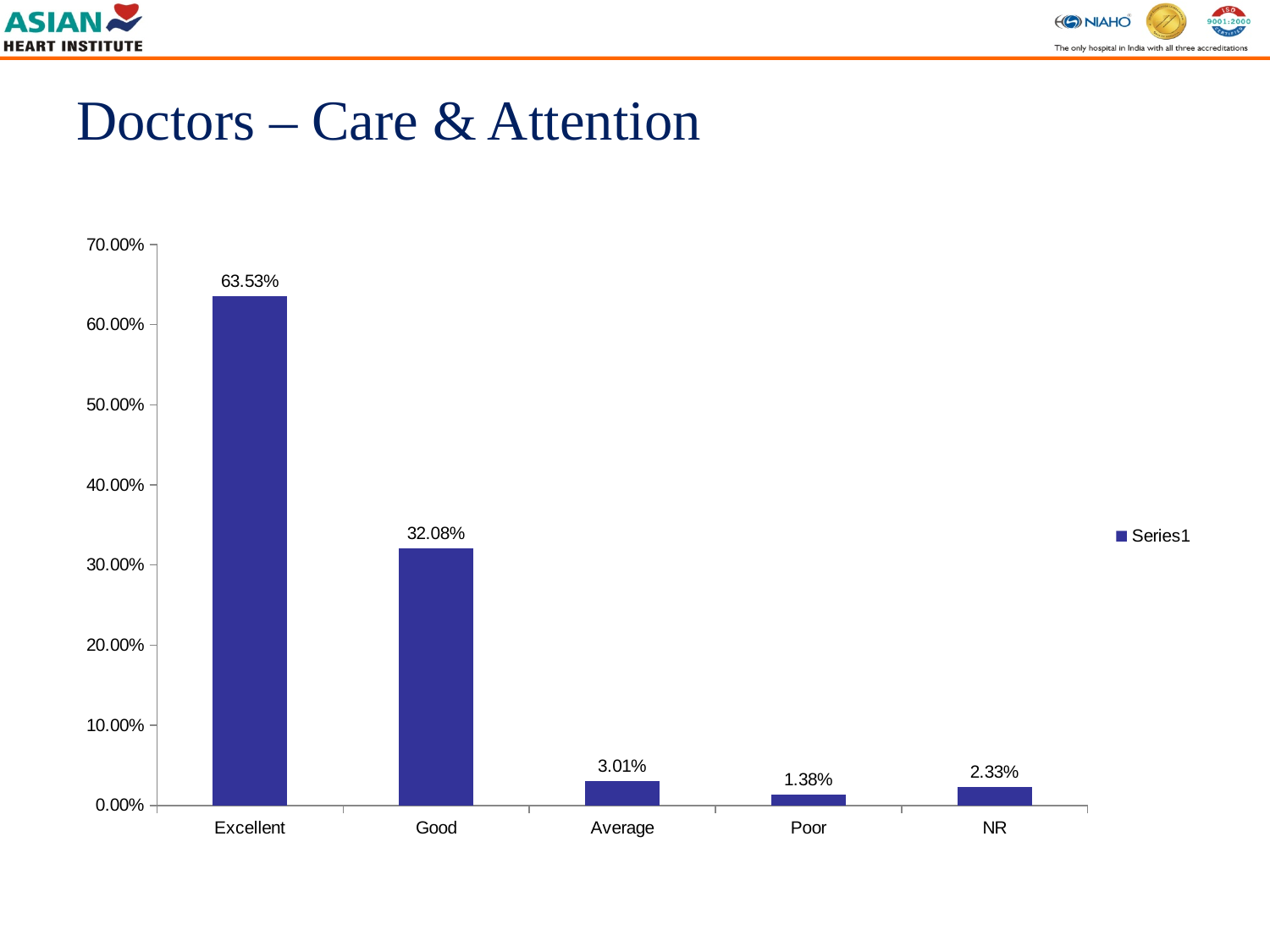
Which is larger, the value for NR or the value for Poor? NR Is the value for Good greater or less than 30.00%? greater What is the value for NR? 2.33% What is the value for Average? 3.01% What is the value for Excellent? 63.53% What is the difference between the values for Excellent and Good? 31.45% Which category has the lowest value? Poor Which category has the highest value? Excellent What is the value for Poor? 1.38% How many categories are shown on the x axis? 5 What is the value for Good? 32.08% What kind of chart is shown on the slide? bar chart